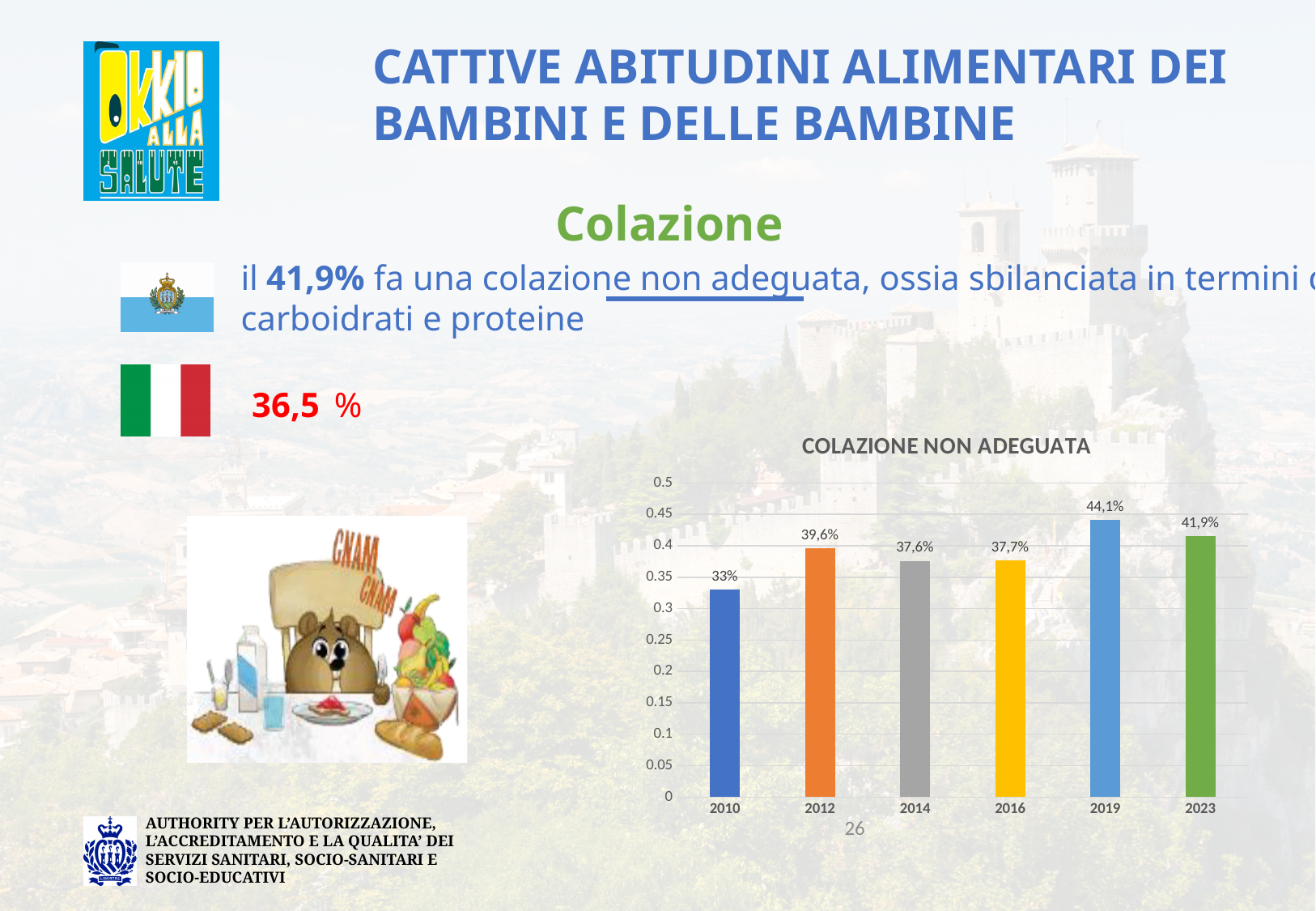
Which year has the highest value in the COLAZIONE NON ADEGUATA chart? 2019 What is the value for 2019 in the COLAZIONE NON ADEGUATA chart? 44,1% Which year has the lowest value in the COLAZIONE NON ADEGUATA chart? 2010 In the COLAZIONE NON ADEGUATA chart, is the value for 2010 greater or less than 0.35? less In the COLAZIONE NON ADEGUATA chart, does the value rise or fall from 2019 to 2023? fall In the COLAZIONE NON ADEGUATA chart, what is the difference between the 2019 value and the 2023 value? 2,2 percentage points How many years are shown on the x axis of the COLAZIONE NON ADEGUATA chart? 6 What kind of chart is the COLAZIONE NON ADEGUATA chart? bar chart What is the value for 2023 in the COLAZIONE NON ADEGUATA chart? 41,9% What is the value for 2012 in the COLAZIONE NON ADEGUATA chart? 39,6% In the COLAZIONE NON ADEGUATA chart, which is larger: the value for 2012 or the value for 2014? 2012 What is the value for 2010 in the COLAZIONE NON ADEGUATA chart? 33%